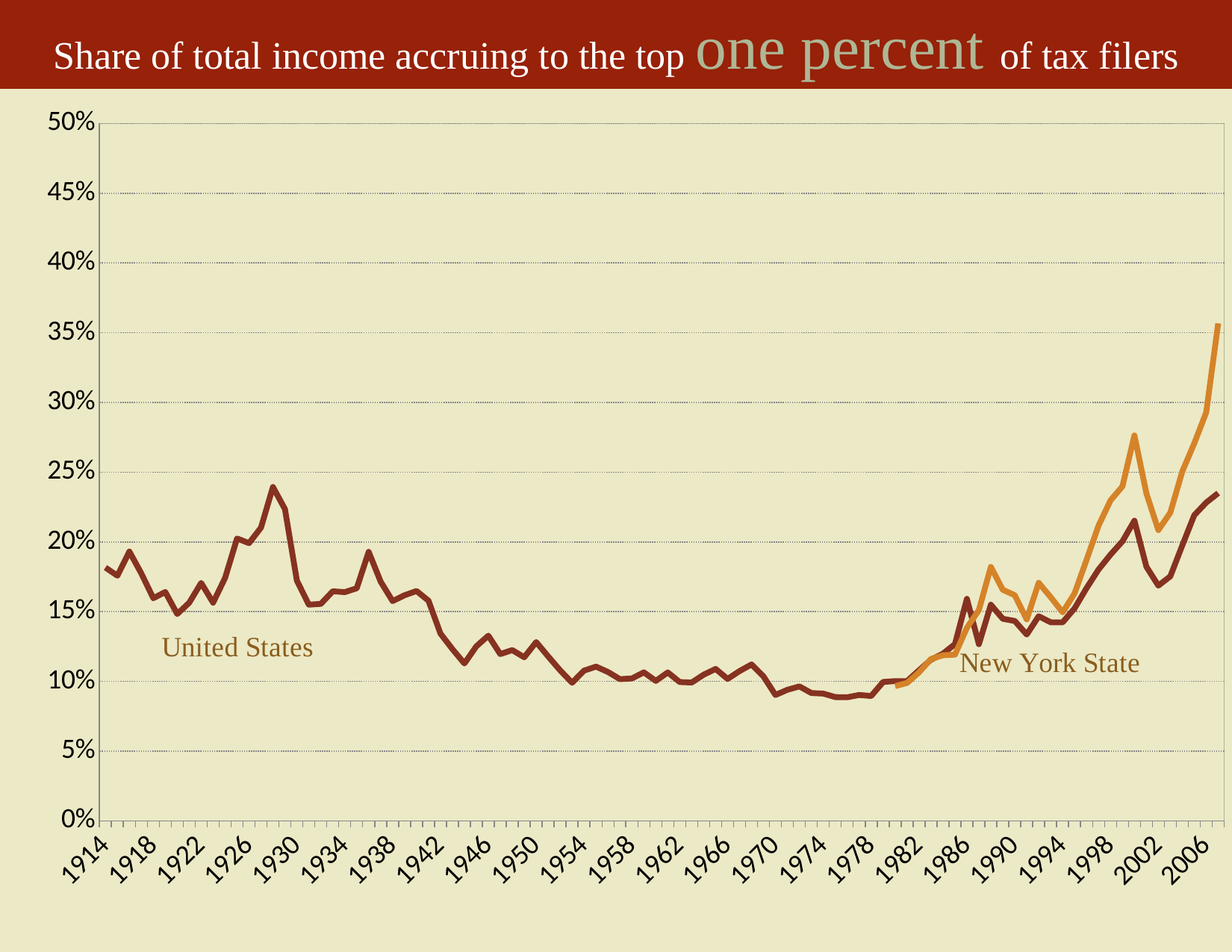
How many series are plotted on the chart? 2 Around 2006, which series has the higher value, United States or New York State? New York State Which series is drawn in orange? New York State Is the United States value in 1974 greater or less than 10%? less What is the title of the chart? Share of total income accruing to the top one percent of tax filers Is the United States peak around 1928 greater or less than 20%? greater Does the United States share generally rise or fall between 1930 and 1974? fall Is the New York State value at the end of the series (around 2006) greater or less than 30%? greater What kind of chart is shown on the slide? line chart Which series reaches the highest value anywhere on the chart? New York State